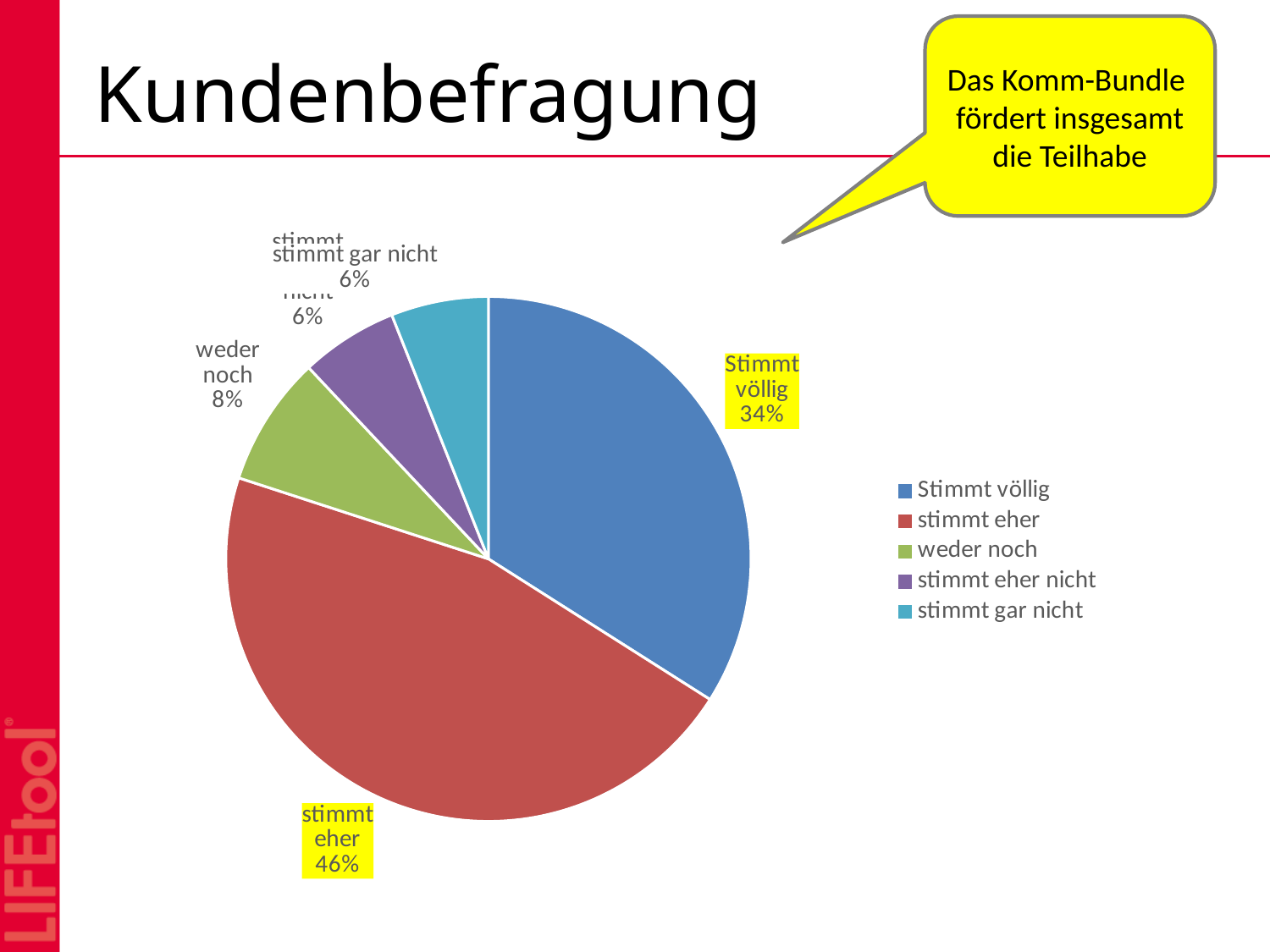
What share of the pie does "Stimmt völlig" have? 34% What share of the pie does "weder noch" have? 8% What is the combined share of "Stimmt völlig" and "stimmt eher"? 80% Which category has the largest slice of the pie? stimmt eher What colour is the "stimmt eher" slice in the pie chart? red How many slices does the pie chart have? 5 What is the difference between the shares of "stimmt eher" and "Stimmt völlig"? 12% What share of the pie does "stimmt eher" have? 46% What kind of chart is shown on the slide? pie chart Which is larger, the share of "Stimmt völlig" or the share of "weder noch"? Stimmt völlig How many entries does the legend list? 5